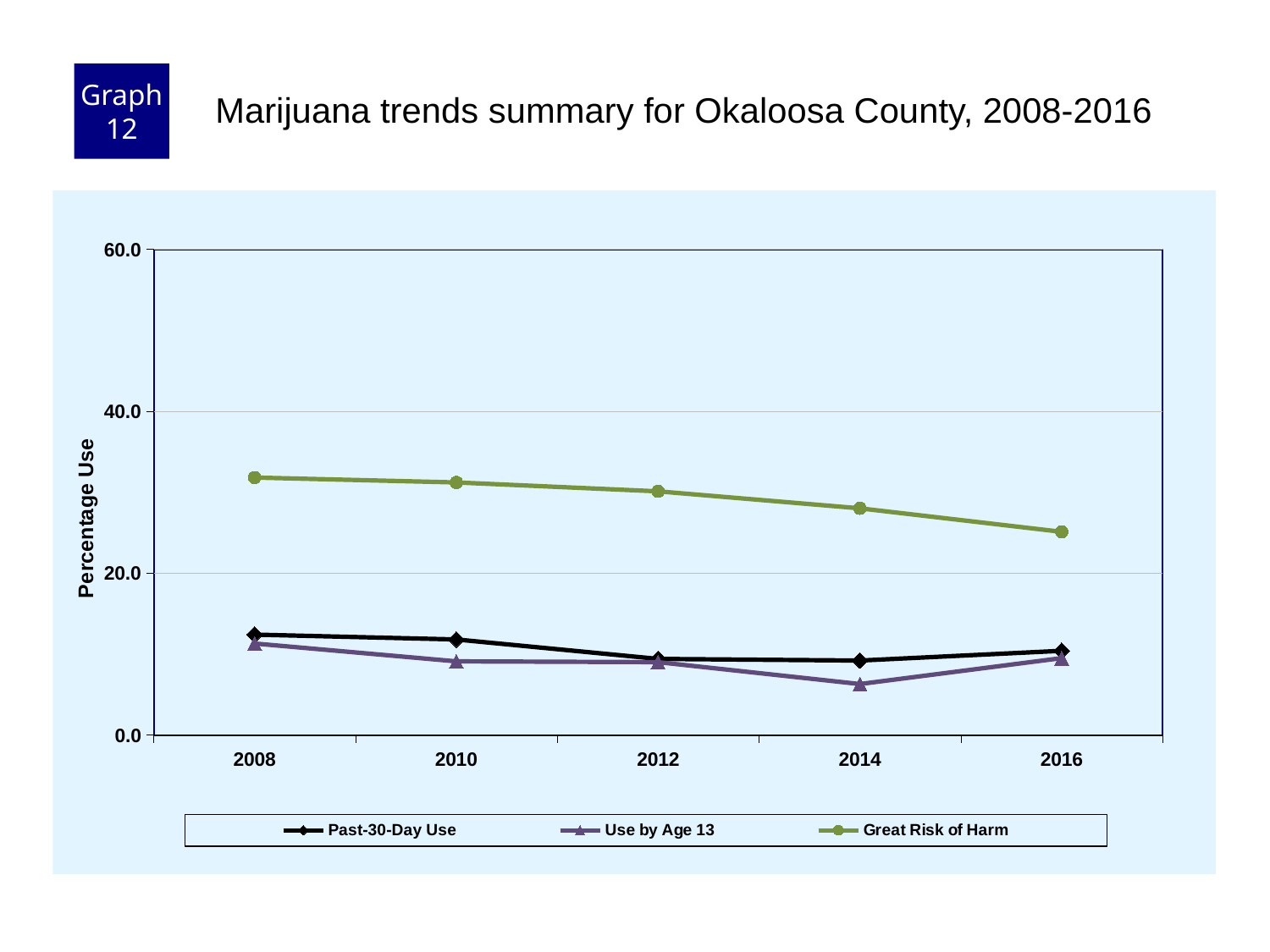
What is the label on the y axis? Percentage Use Does the Great Risk of Harm line rise or fall from 2008 to 2016? Falls Is the value for Past-30-Day Use in 2014 greater or less than 20.0? less For Past-30-Day Use, which year has the larger value: 2008 or 2014? 2008 What kind of chart is shown on the slide? Line chart In 2012, which is larger: Great Risk of Harm or Past-30-Day Use? Great Risk of Harm Is the value for Great Risk of Harm in 2016 greater or less than 40.0? less How many years are plotted along the x axis? 5 In which year is the Use by Age 13 value lowest? 2014 In which year is the Great Risk of Harm value lowest? 2016 Is the value for Great Risk of Harm in 2008 greater or less than 20.0? greater How many series does the legend list? 3